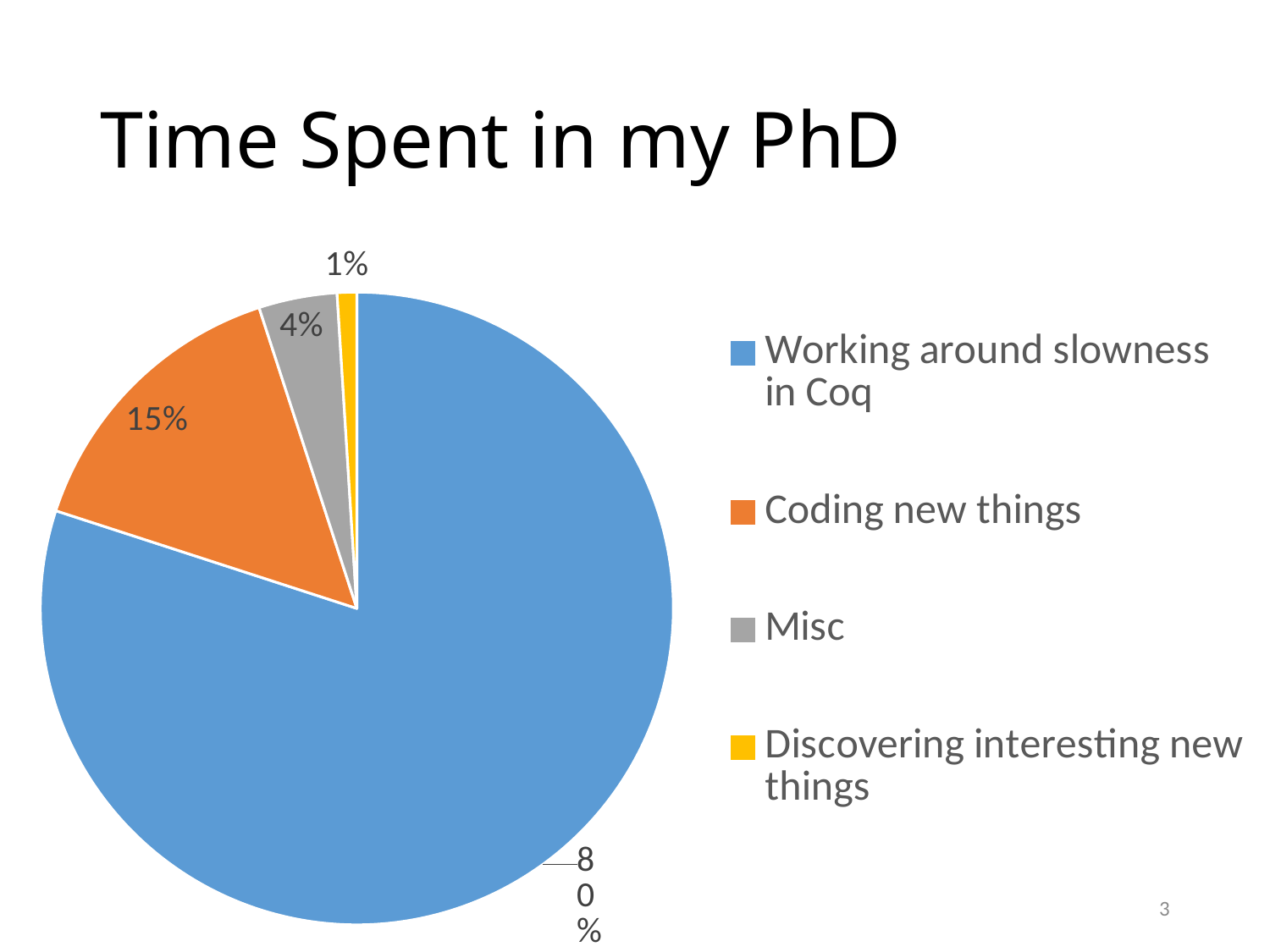
Which category has the smallest slice of the pie? Discovering interesting new things Which is larger, the slice for "Misc" or the slice for "Coding new things"? Coding new things What kind of chart is shown on the slide? pie chart What share of the pie is labelled for "Working around slowness in Coq"? 80% What share of the pie is labelled for "Discovering interesting new things"? 1% How many categories does the pie chart show? 4 What share of the pie is labelled for "Misc"? 4% What is the title of the chart on the slide? Time Spent in my PhD Which category has the largest slice of the pie? Working around slowness in Coq What is the difference in percentage points between "Working around slowness in Coq" and "Coding new things"? 65 What colour is the slice for "Misc"? grey